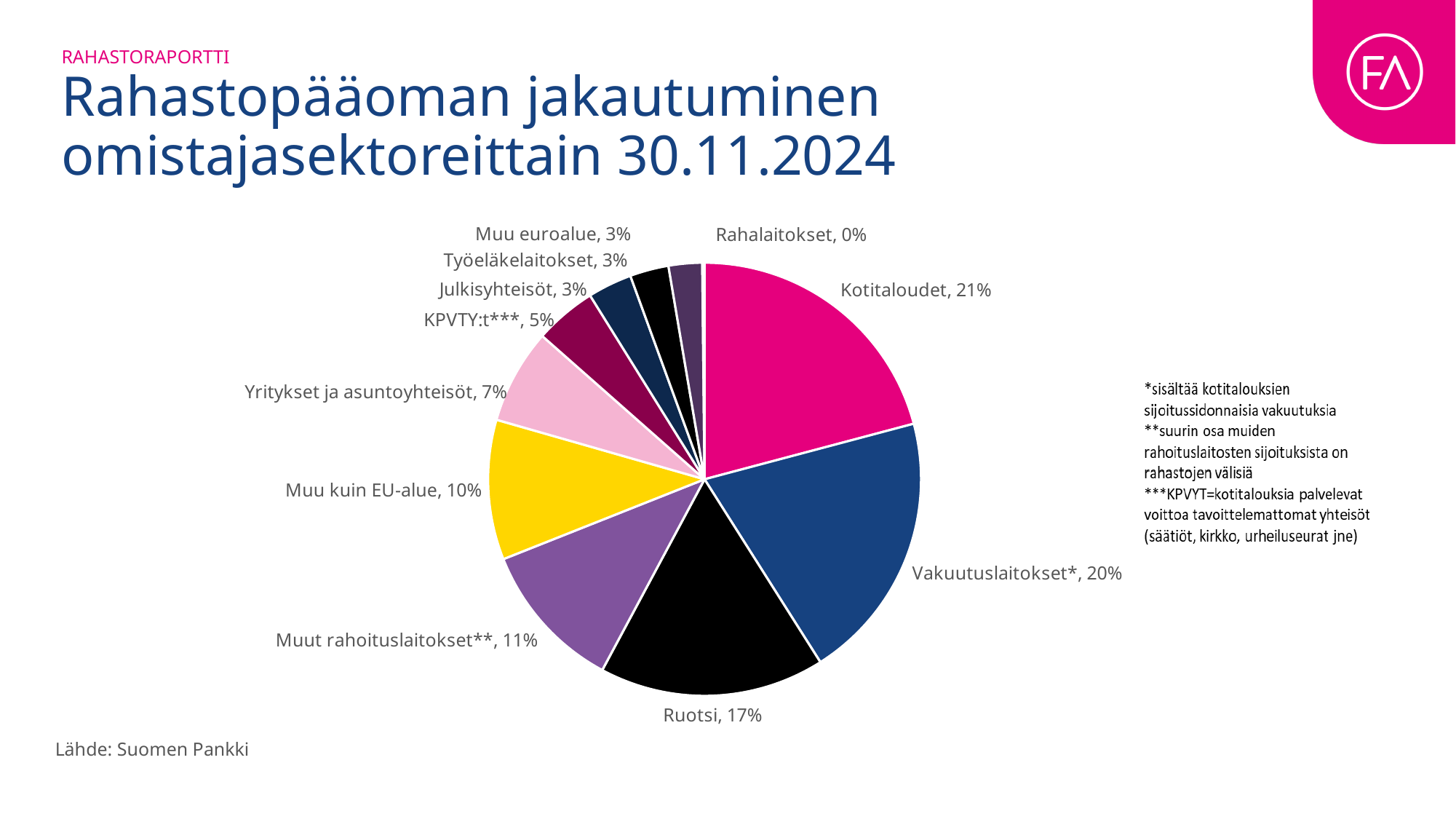
What is the value shown for Vakuutuslaitokset*? 20% What is the value shown for Ruotsi? 17% What is the value shown for Muu kuin EU-alue? 10% Which category has the smallest slice of the pie? Rahalaitokset What is the value shown for KPVTY:t***? 5% What kind of chart is shown on the slide? Pie chart What share of the pie does Kotitaloudet hold? 21% How many categories are shown in the pie chart? 11 Which category has the largest slice of the pie? Kotitaloudet What source is cited for the chart data? Suomen Pankki Which is larger, the share of Muut rahoituslaitokset** or the share of Yritykset ja asuntoyhteisöt? Muut rahoituslaitokset** What is the difference between the shares of Kotitaloudet and Ruotsi? 4 percentage points